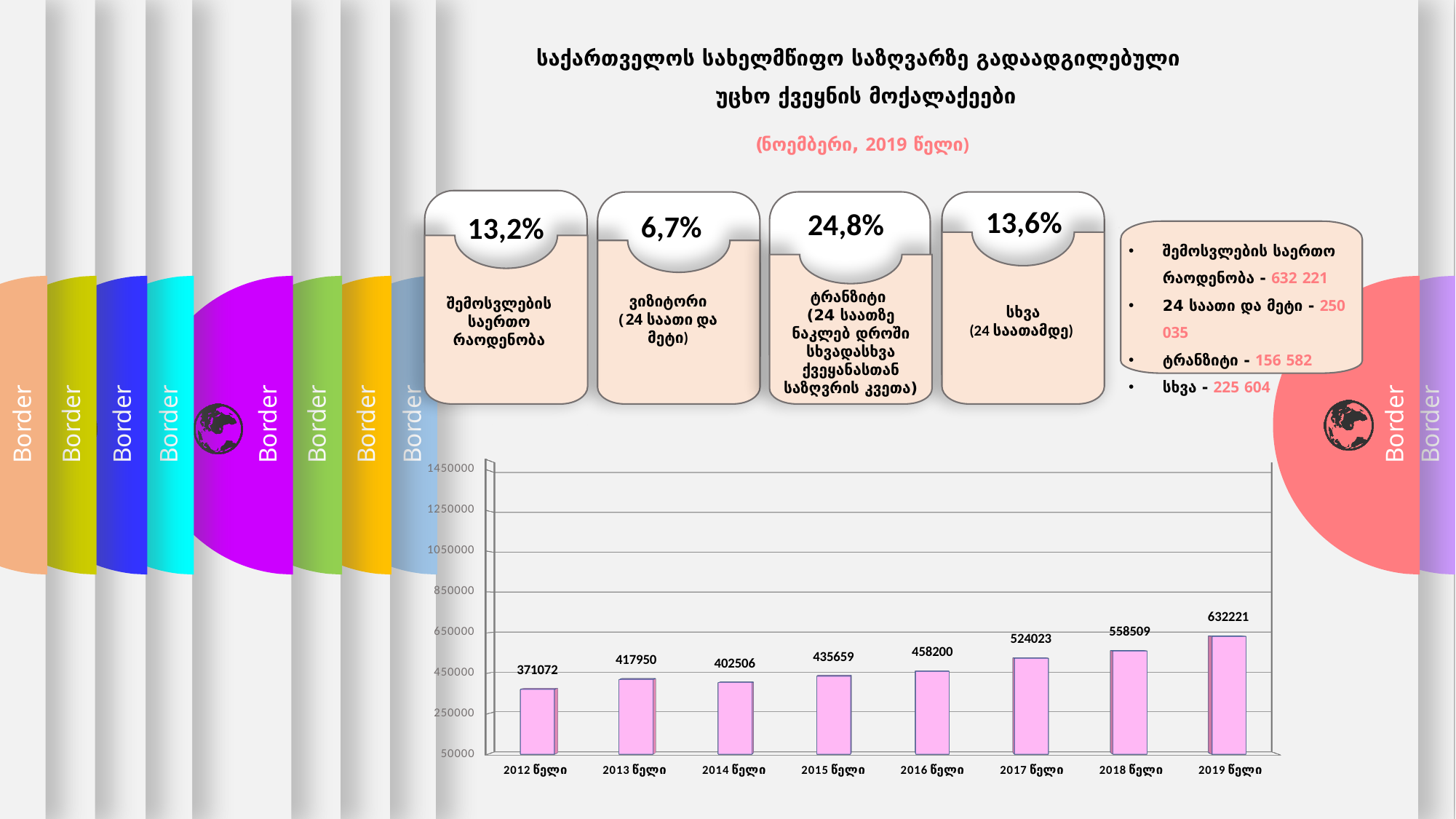
How many years are shown on the x axis of the bar chart? 8 Which is larger, the value for 2013 წელი or the value for 2014 წელი? 2013 წელი What is the value for 2012 წელი? 371072 What is the value for 2017 წელი? 524023 Do the values generally rise or fall from 2012 წელი to 2019 წელი? rise Which year has the highest value? 2019 წელი What kind of chart is shown at the bottom of the slide? bar chart Which year has the lowest value? 2012 წელი What is the difference between the values for 2013 წელი and 2014 წელი? 15444 What is the value for 2019 წელი? 632221 What is the difference between the values for 2019 წელი and 2018 წელი? 73712 Is the value for 2016 წელი greater or less than 450000? greater